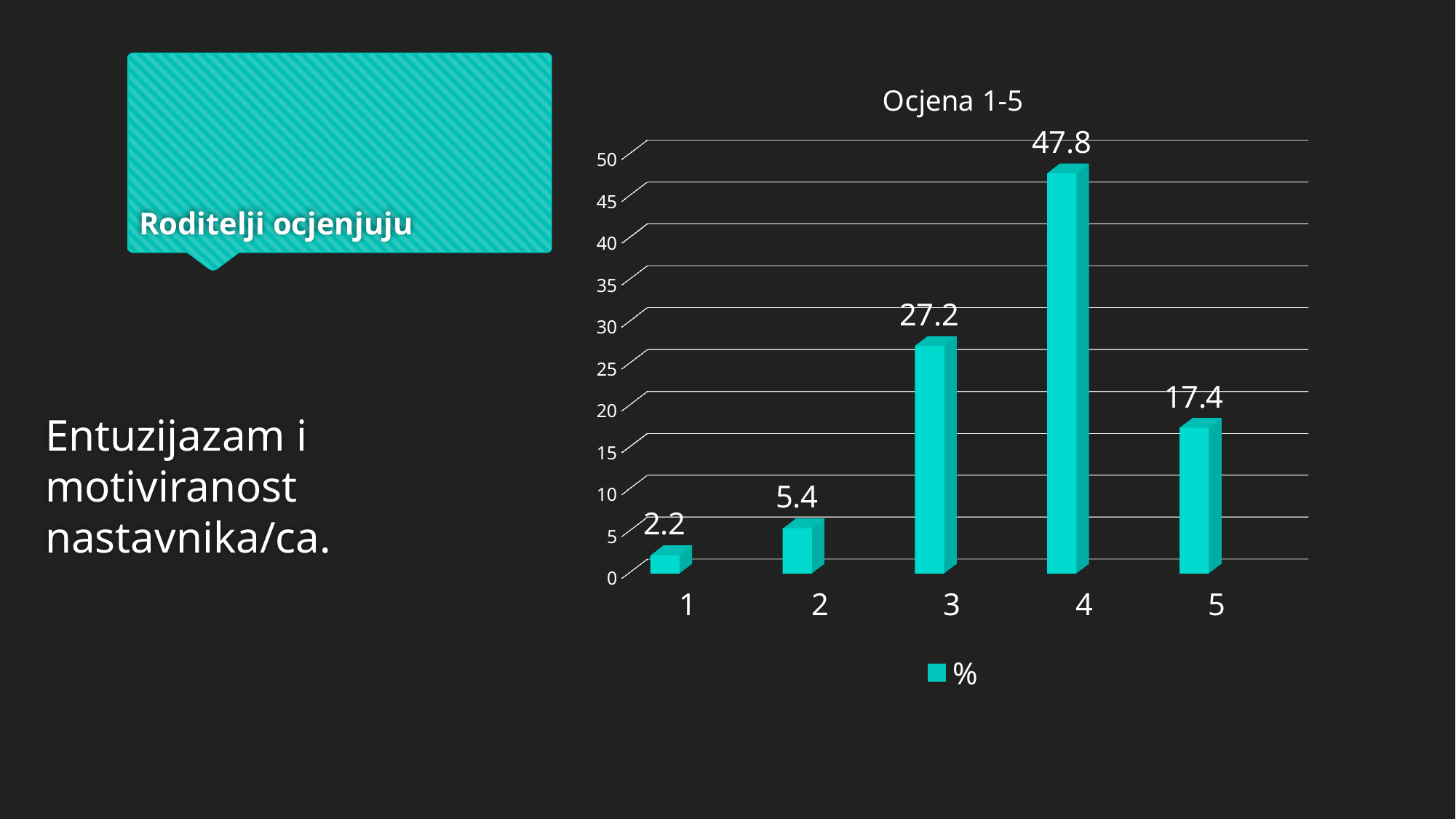
What is the difference between the values for categories 4 and 3? 20.6 Which is larger, the value for category 3 or category 5? 3 Is the value for category 2 greater or less than 10? less Which category has the lowest value? 1 What kind of chart is shown? bar chart What is the value for category 5? 17.4 How many categories are shown on the x axis? 5 What is the value for category 4? 47.8 How many series does the legend list? 1 What is the title of the chart? Ocjena 1-5 Which category has the highest value? 4 What is the value for category 1? 2.2